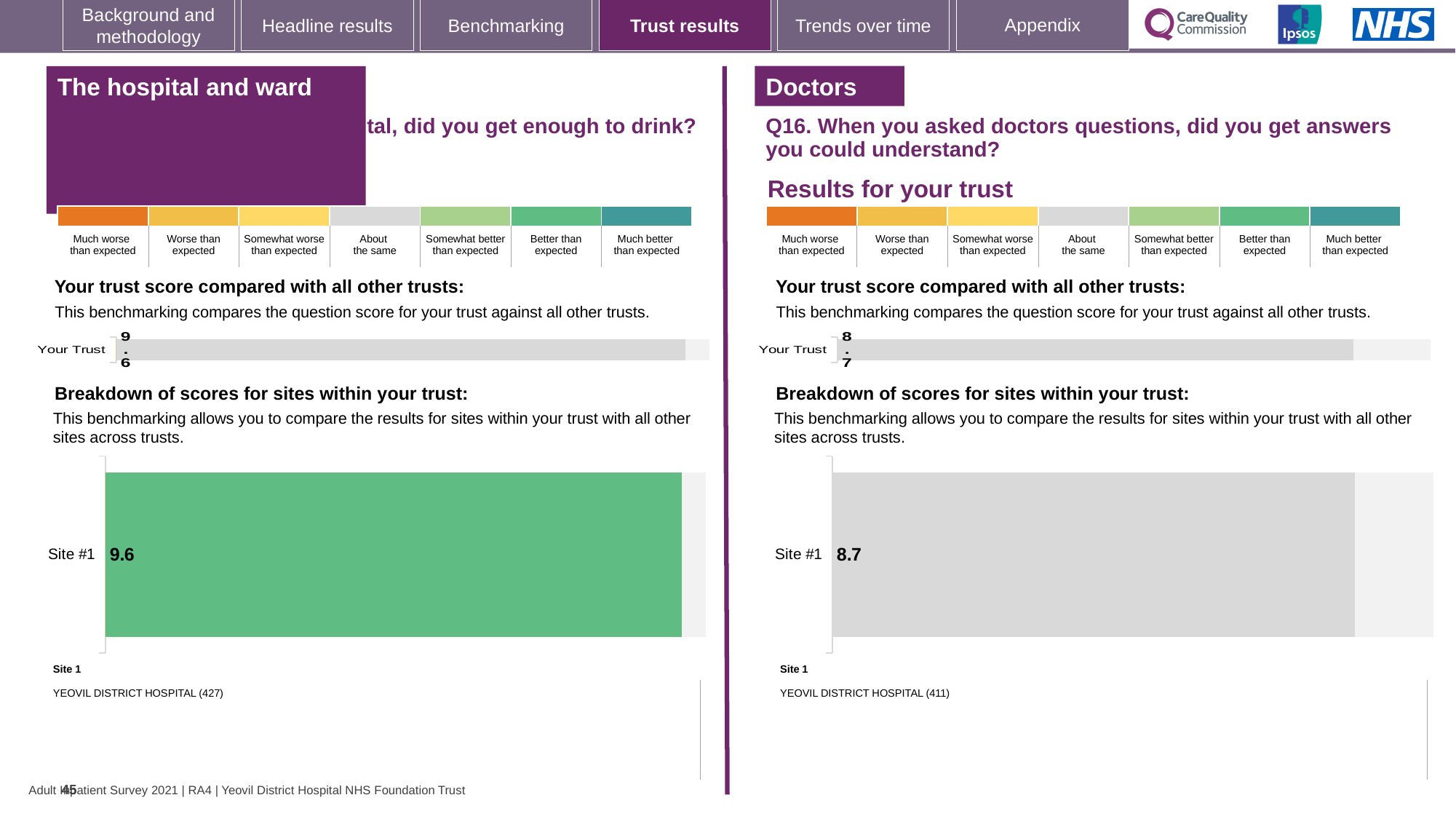
Which site is listed as Site 1 beneath the right-hand site breakdown chart? YEOVIL DISTRICT HOSPITAL (411) Which is larger: the Site #1 score on the left-hand site breakdown chart or the Site #1 score on the right-hand site breakdown chart? Left-hand (9.6) What is the difference between the Your Trust score on the left-hand chart (9.6) and the Your Trust score on the right-hand chart (8.7)? 0.9 On the right-hand 'Breakdown of scores for sites within your trust' chart (Doctors, Q16), what is the score for Site #1? 8.7 What type of chart is used for the Site #1 breakdown on the left-hand side of the slide? Bar chart What colour is the Site #1 bar on the right-hand 'Breakdown of scores for sites within your trust' chart? Grey What colour is the Site #1 bar on the left-hand 'Breakdown of scores for sites within your trust' chart? Green On the right-hand 'Your trust score compared with all other trusts' chart (Doctors, Q16), what is the score for Your Trust? 8.7 On the left-hand 'Breakdown of scores for sites within your trust' chart, what is the score for Site #1? 9.6 How many sites are shown on the right-hand 'Breakdown of scores for sites within your trust' chart? 1 How many sites are shown on the left-hand 'Breakdown of scores for sites within your trust' chart? 1 On the left-hand 'Your trust score compared with all other trusts' chart (The hospital and ward section), what is the score for Your Trust? 9.6